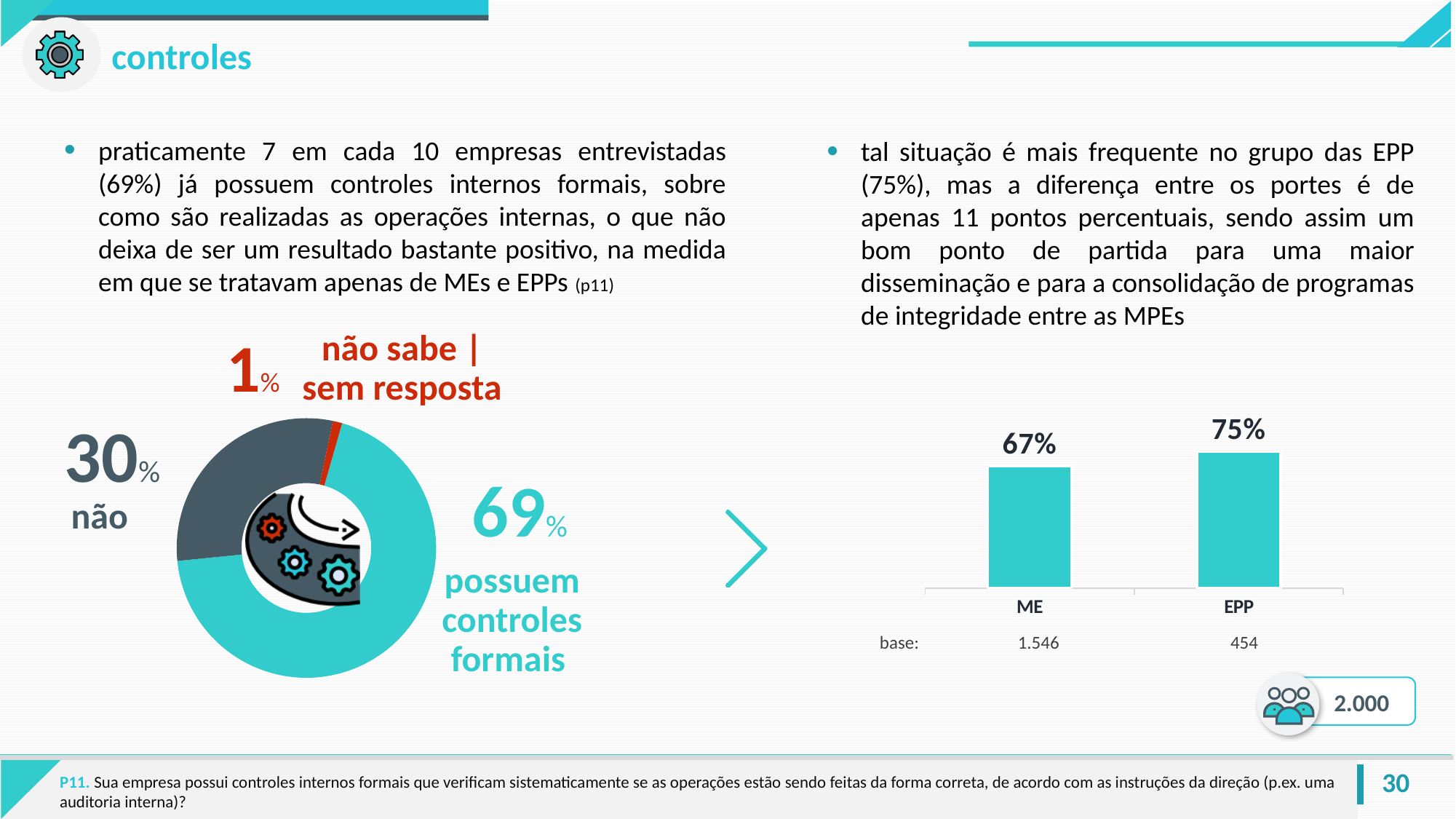
In the bar chart on the right, which category has the higher value, ME or EPP? EPP What kind of chart is shown on the right side of the slide? bar chart In the donut chart on the left, which slice is the smallest? não sabe | sem resposta In the bar chart on the right, what is the value for EPP? 75% In the bar chart on the right, what is the difference between the EPP and ME values? 8 percentage points In the donut chart on the left, what share of companies have formal internal controls (possuem controles formais)? 69% In the donut chart on the left, what share of companies answered 'não'? 30% In the donut chart on the left, which slice is the largest? possuem controles formais In the donut chart on the left, how many slices are there? 3 In the bar chart on the right, what is the base (number of respondents) shown for ME? 1.546 In the donut chart on the left, what share corresponds to 'não sabe | sem resposta'? 1% In the bar chart on the right, what is the value for ME? 67%